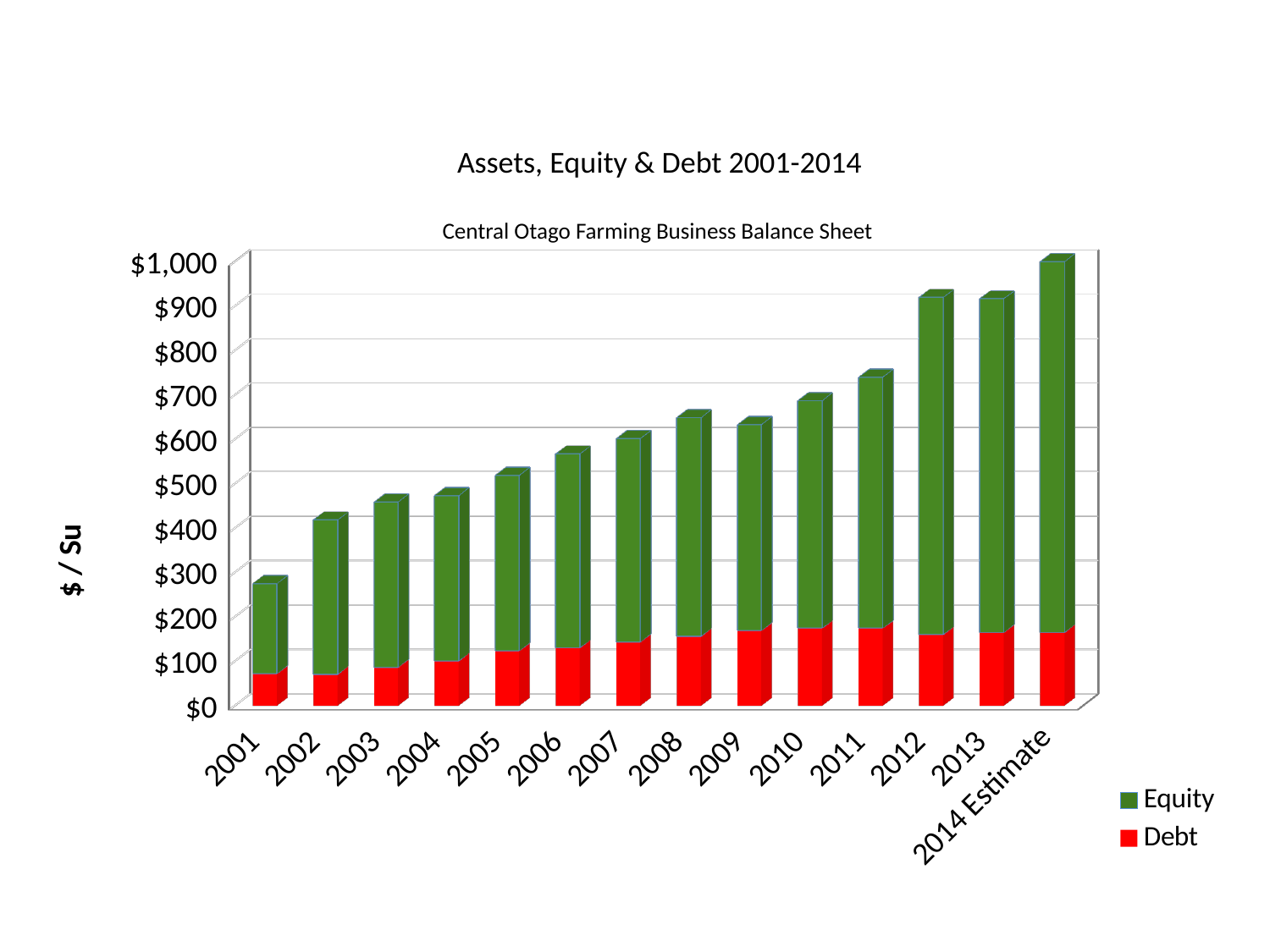
What kind of chart is shown on the slide? Stacked bar chart Which year has the lowest total bar? 2001 Is the total bar for 2014 Estimate greater or less than $900? greater What colour represents Debt in the chart? Red Is the Debt value for 2010 greater or less than $100? greater Do the total bars generally rise or fall from 2001 to 2014 Estimate? rise How many series does the legend list? 2 Is the Debt value for 2001 greater or less than $100? less How many years (categories) are shown along the x axis? 14 Which year has the highest total bar? 2014 Estimate Which has the larger total bar, 2011 or 2012? 2012